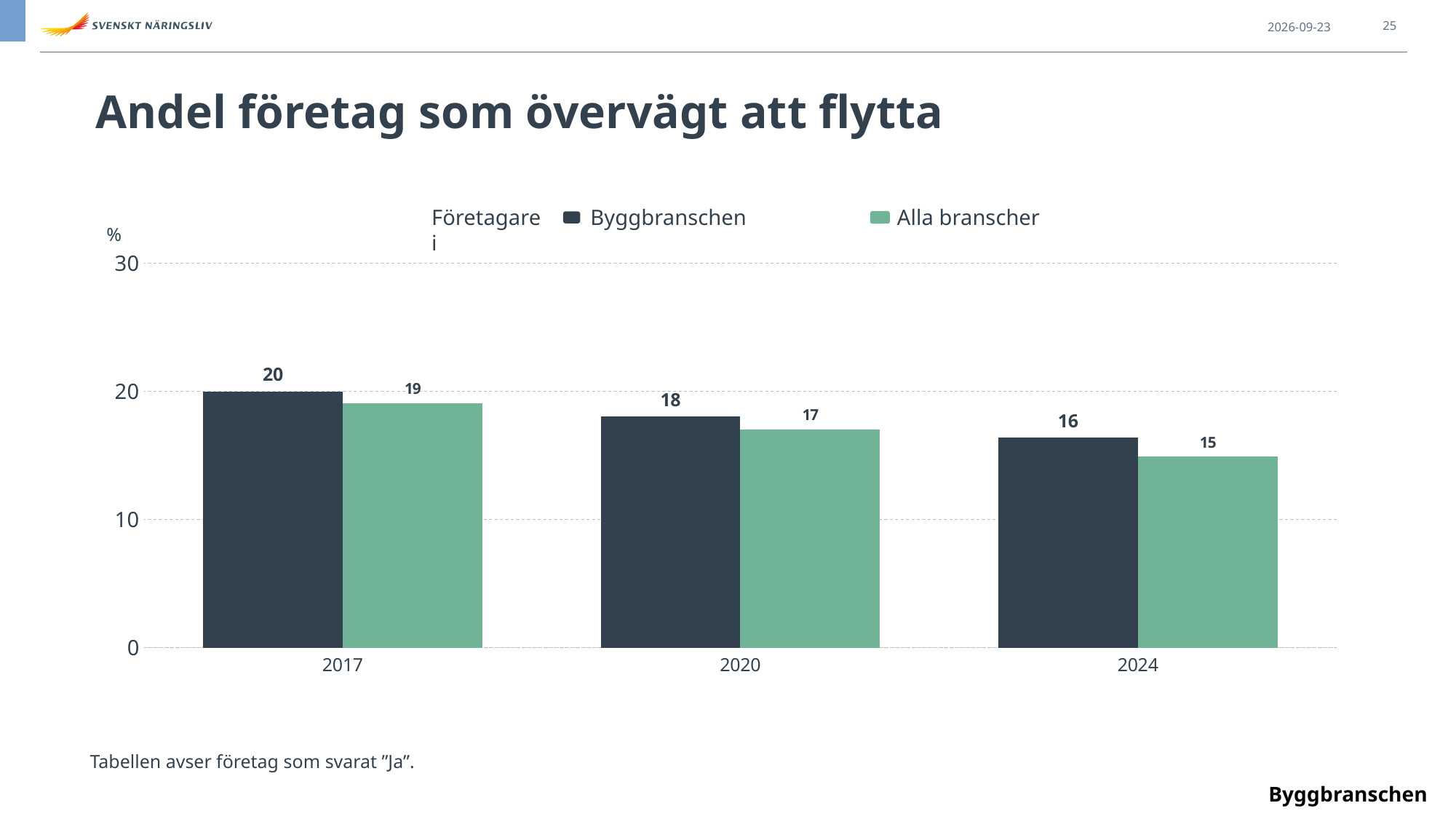
What is the value for Alla branscher in 2020? 17 What is the difference between Byggbranschen and Alla branscher in 2020? 1 Which is larger in 2024, Byggbranschen or Alla branscher? Byggbranschen What kind of chart is shown on the slide? Bar chart What is the value for Byggbranschen in 2017? 20 What is the value for Alla branscher in 2024? 15 By how much did the Byggbranschen value fall from 2017 to 2024? 4 How many years are shown on the x axis? 3 Do the Alla branscher values rise or fall from 2017 to 2024? Fall In which year is the Alla branscher value lowest? 2024 How many series does the legend list? 2 In which year is the Byggbranschen value highest? 2017